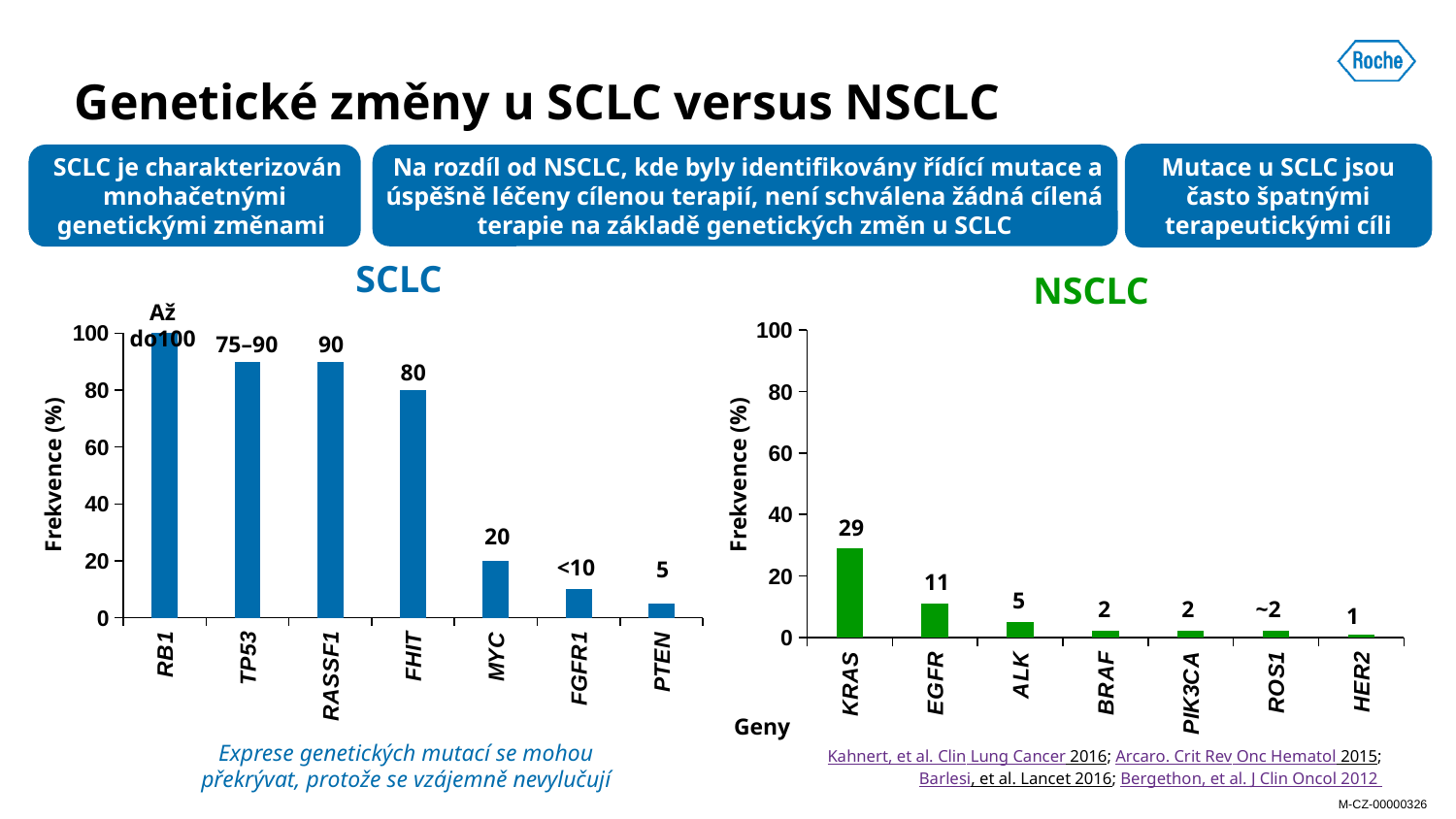
In the NSCLC chart, what is the frequency (%) for EGFR? 11 In the NSCLC chart, what is the difference in frequency between KRAS and EGFR? 18 In the SCLC chart, which has a higher frequency, MYC or PTEN? MYC In the NSCLC chart, what is the frequency (%) for KRAS? 29 In the SCLC chart, what is the difference in frequency between MYC and PTEN? 15 How many genes are shown on the x axis of the NSCLC chart? 7 In the NSCLC chart, which gene has the highest frequency? KRAS In the SCLC chart, which gene has the highest frequency? RB1 In the SCLC chart, what is the frequency (%) for FHIT? 80 In the SCLC chart, what value is shown for TP53? 75–90 In the NSCLC chart, which gene has the lowest frequency? HER2 In the SCLC chart, what is the frequency (%) for RASSF1? 90